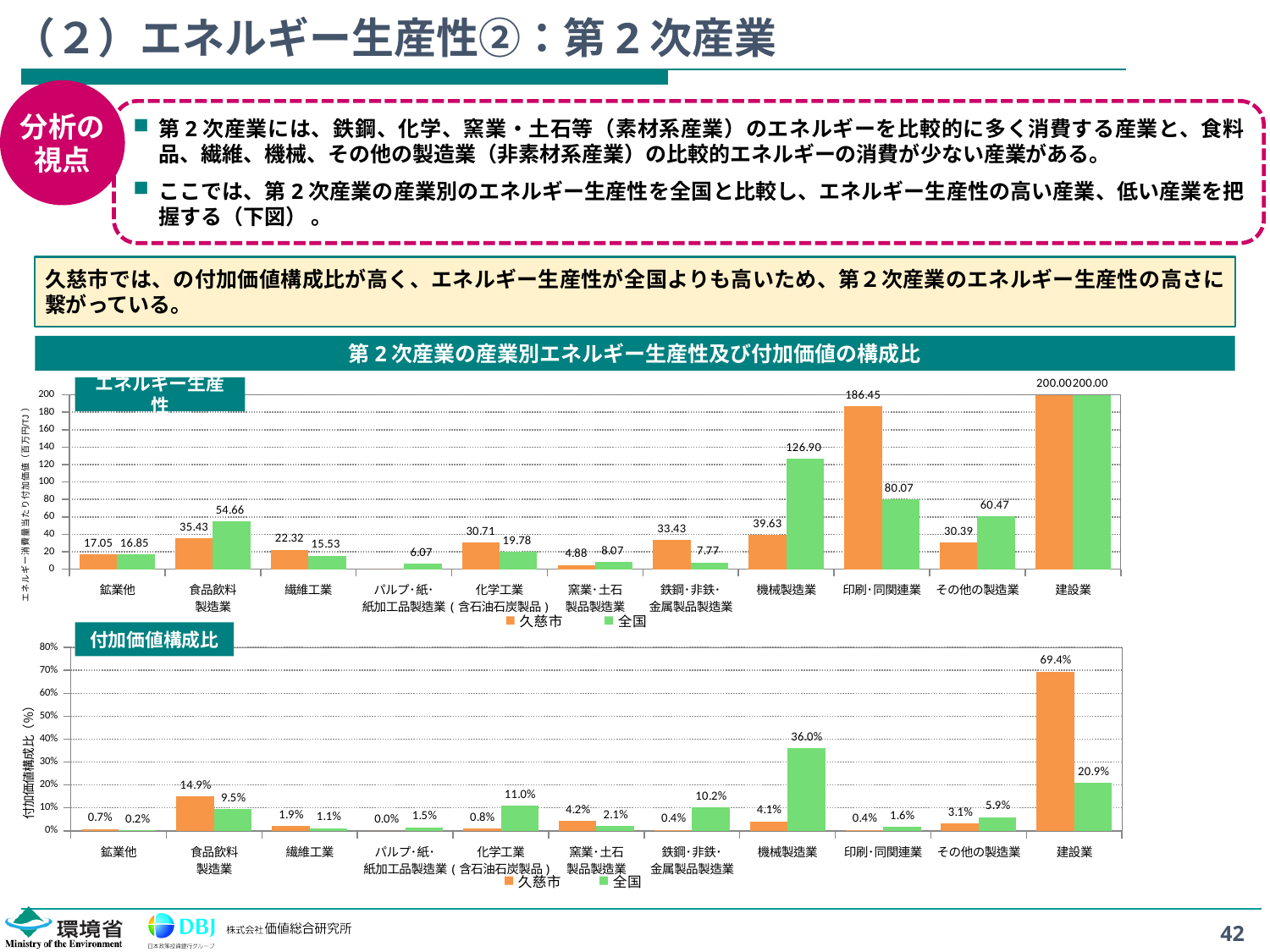
In the top chart (エネルギー生産性), which is larger in 鉄鋼・非鉄・金属製品製造業, 久慈市 or 全国? 久慈市 In the top chart (エネルギー生産性), what is the difference between 全国 and 久慈市 in 食品飲料製造業? 19.23 In the top chart (エネルギー生産性), what is the value for 全国 in 機械製造業? 126.90 How many industry categories are shown on the x axis of the top chart (エネルギー生産性)? 11 In the top chart (エネルギー生産性), which category has the lowest value for 久慈市 among those with a printed label? 窯業・土石製品製造業 How many series does the legend of the bottom chart (付加価値構成比) list? 2 In the bottom chart (付加価値構成比), what is the difference between 久慈市 and 全国 in 建設業? 48.5% In the top chart (エネルギー生産性), what is the value for 久慈市 in 印刷・同関連業? 186.45 What type of chart is the top chart (エネルギー生産性)? Bar chart In the bottom chart (付加価値構成比), what is the value for 久慈市 in 建設業? 69.4% In the bottom chart (付加価値構成比), which category has the highest value for 全国? 機械製造業 In the bottom chart (付加価値構成比), which is larger in 化学工業, 久慈市 or 全国? 全国